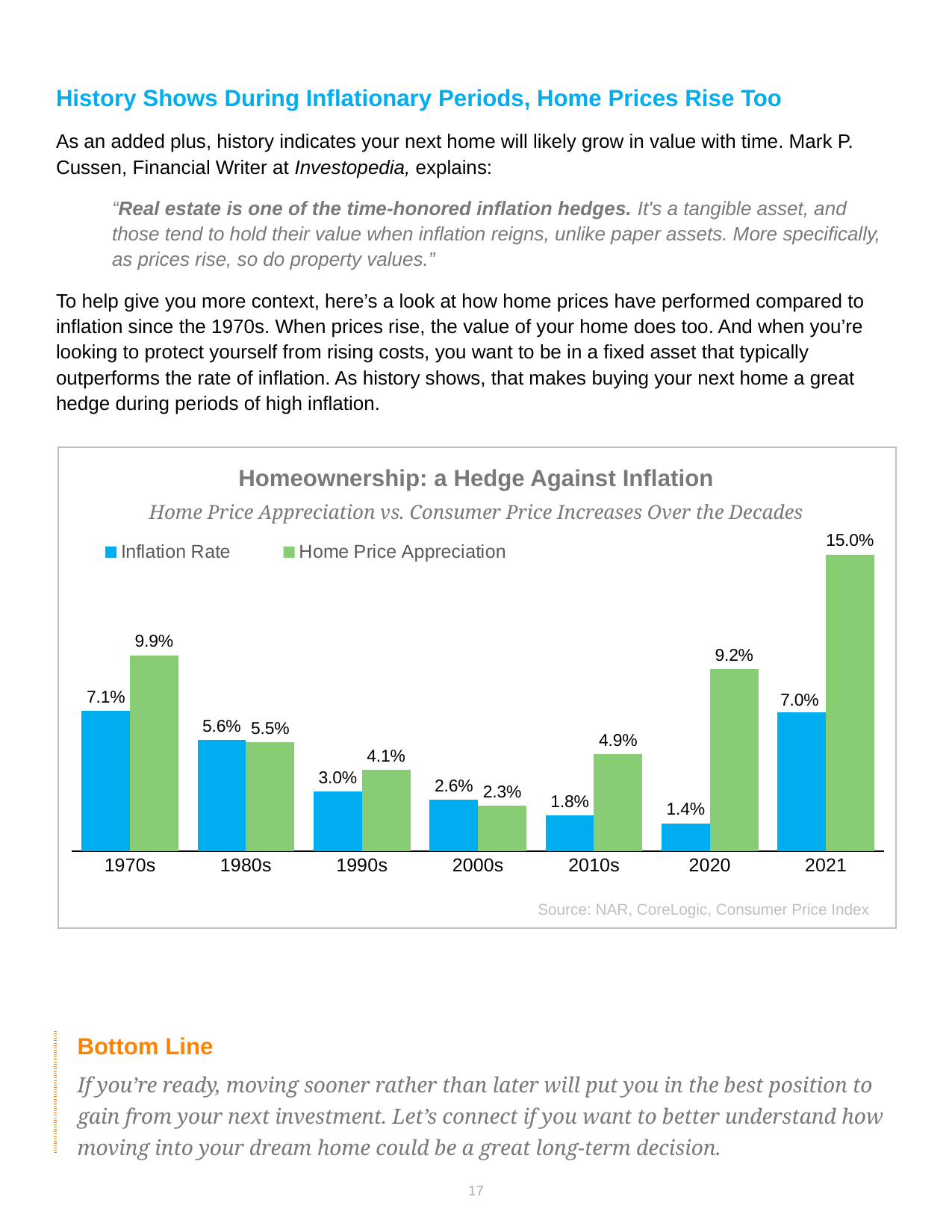
In the 1990s, which is larger: the Inflation Rate or Home Price Appreciation? Home Price Appreciation Which period has the highest Home Price Appreciation? 2021 What is the difference between Home Price Appreciation and Inflation Rate in 2020? 7.8% What is the Inflation Rate for the 2010s? 1.8% What kind of chart is shown? Bar chart What is the Home Price Appreciation value for 2020? 9.2% Which period has the lowest Inflation Rate? 2020 What is the title of the chart? Homeownership: a Hedge Against Inflation How many periods are shown on the x axis? 7 How many series does the legend list? 2 What is the Inflation Rate for the 1970s? 7.1% What is the Home Price Appreciation value for 2021? 15.0%